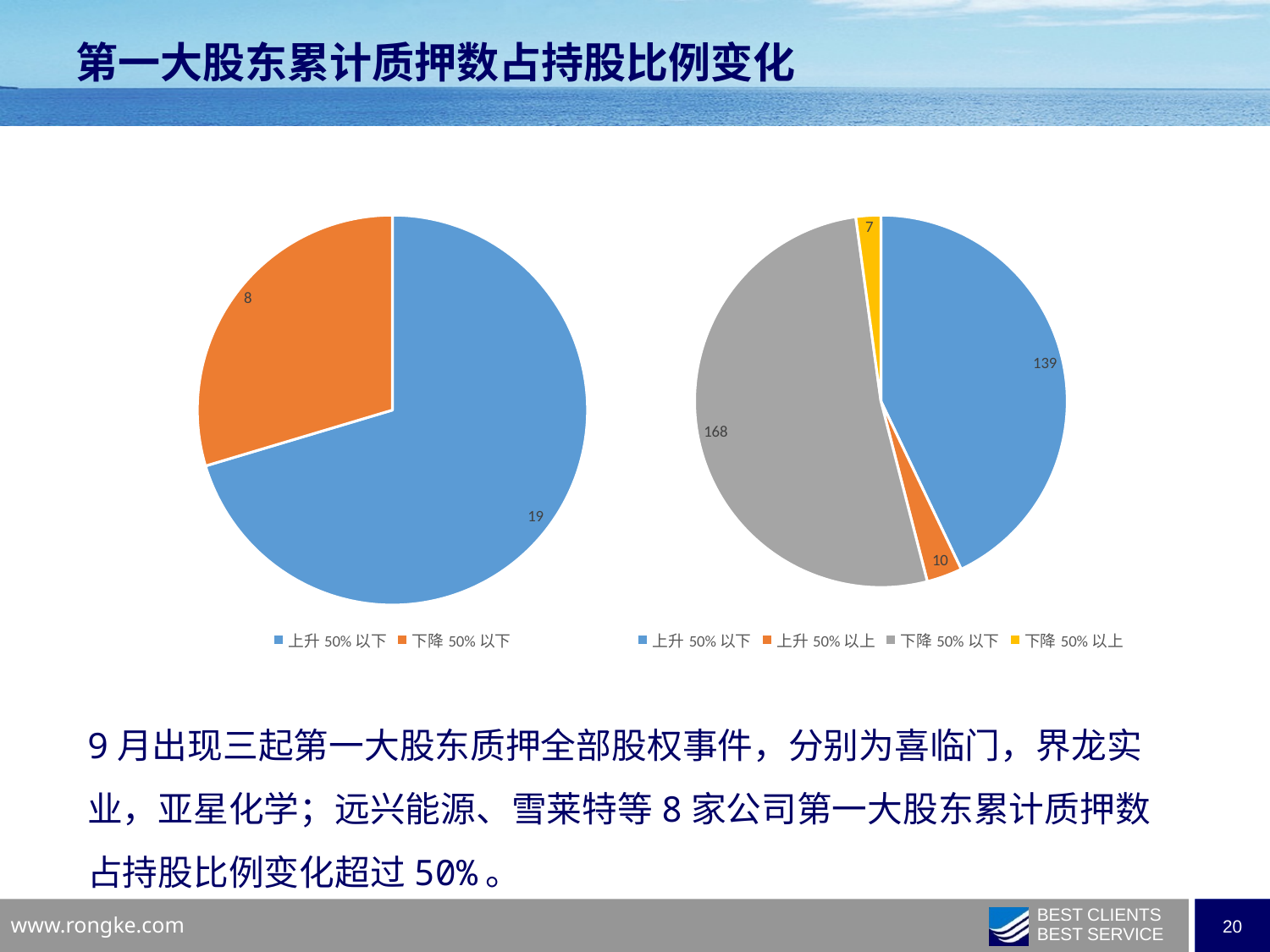
How many categories does the legend of the right pie chart list? 4 In the left pie chart, what is the difference between 上升 50% 以下 and 下降 50% 以下? 11 In the right pie chart, what is the value for 下降 50% 以下? 168 In the left pie chart, what is the value for 上升 50% 以下? 19 In the right pie chart, what is the value for 上升 50% 以上? 10 In the right pie chart, what is the value for 下降 50% 以上? 7 In the right pie chart, what is the difference between 下降 50% 以下 and 上升 50% 以下? 29 What type of chart is shown on the left of the slide? Pie chart In the right pie chart, which category has the smallest value? 下降 50% 以上 In the right pie chart, which category has the largest value? 下降 50% 以下 In the right pie chart, which is larger: 上升 50% 以上 or 下降 50% 以上? 上升 50% 以上 In the left pie chart, what is the value for 下降 50% 以下? 8